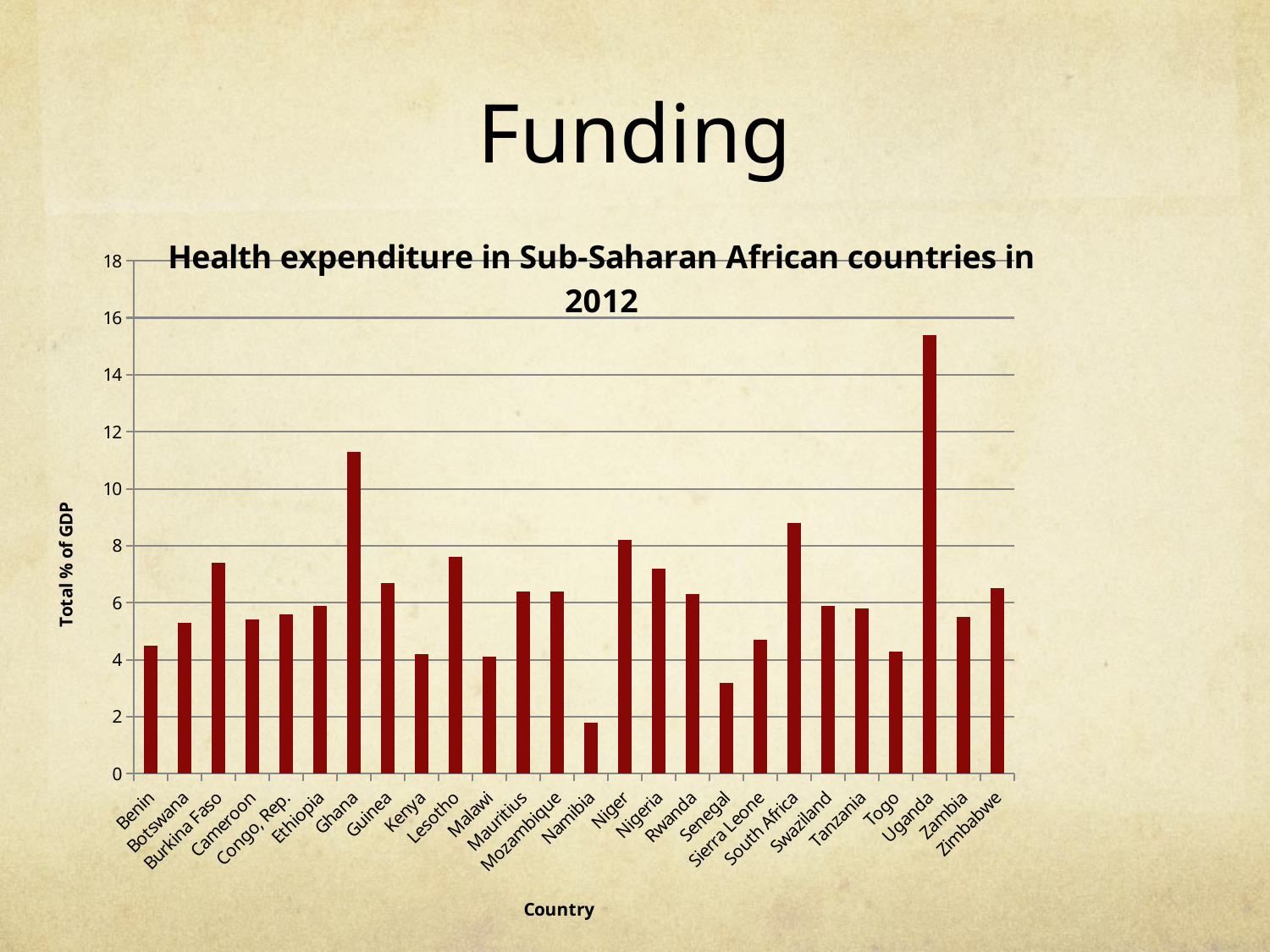
Is the value for South Africa greater or less than 8? greater Is the value for Senegal greater or less than 4? less Which has a higher value, Burkina Faso or Cameroon? Burkina Faso How many countries are shown on the x axis? 26 What is the title of the chart? Health expenditure in Sub-Saharan African countries in 2012 Is the value for Uganda greater or less than 14? greater Which country has the lowest health expenditure as a percentage of GDP? Namibia Which has a higher value, Ghana or South Africa? Ghana Which country has the highest health expenditure as a percentage of GDP? Uganda What kind of chart is shown on the slide? Bar chart